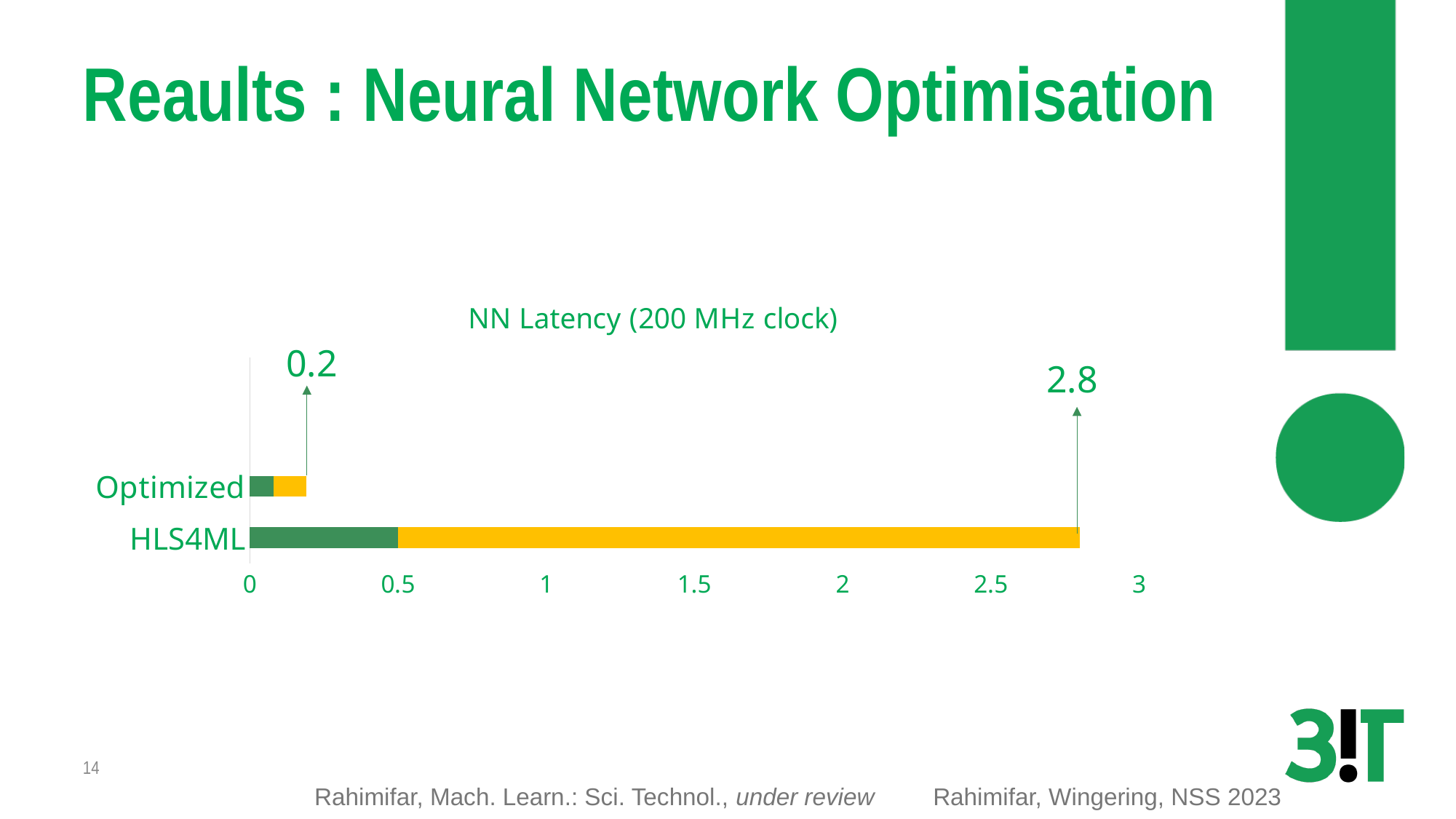
How many categories are plotted in the chart? 2 Is the value for HLS4ML greater or less than 2? greater What kind of chart is shown on the slide? bar chart Which bar is longer, HLS4ML or Optimized? HLS4ML What is the difference between the HLS4ML latency and the Optimized latency? 2.6 At what x-axis value does the green segment of the HLS4ML bar end? 0.5 What is the total latency value labelled for the HLS4ML bar? 2.8 Which category has the highest latency? HLS4ML Is the value for Optimized greater or less than 0.5? less What is the title of the chart? NN Latency (200 MHz clock) What is the total latency value labelled for the Optimized bar? 0.2 Which category has the lowest latency? Optimized